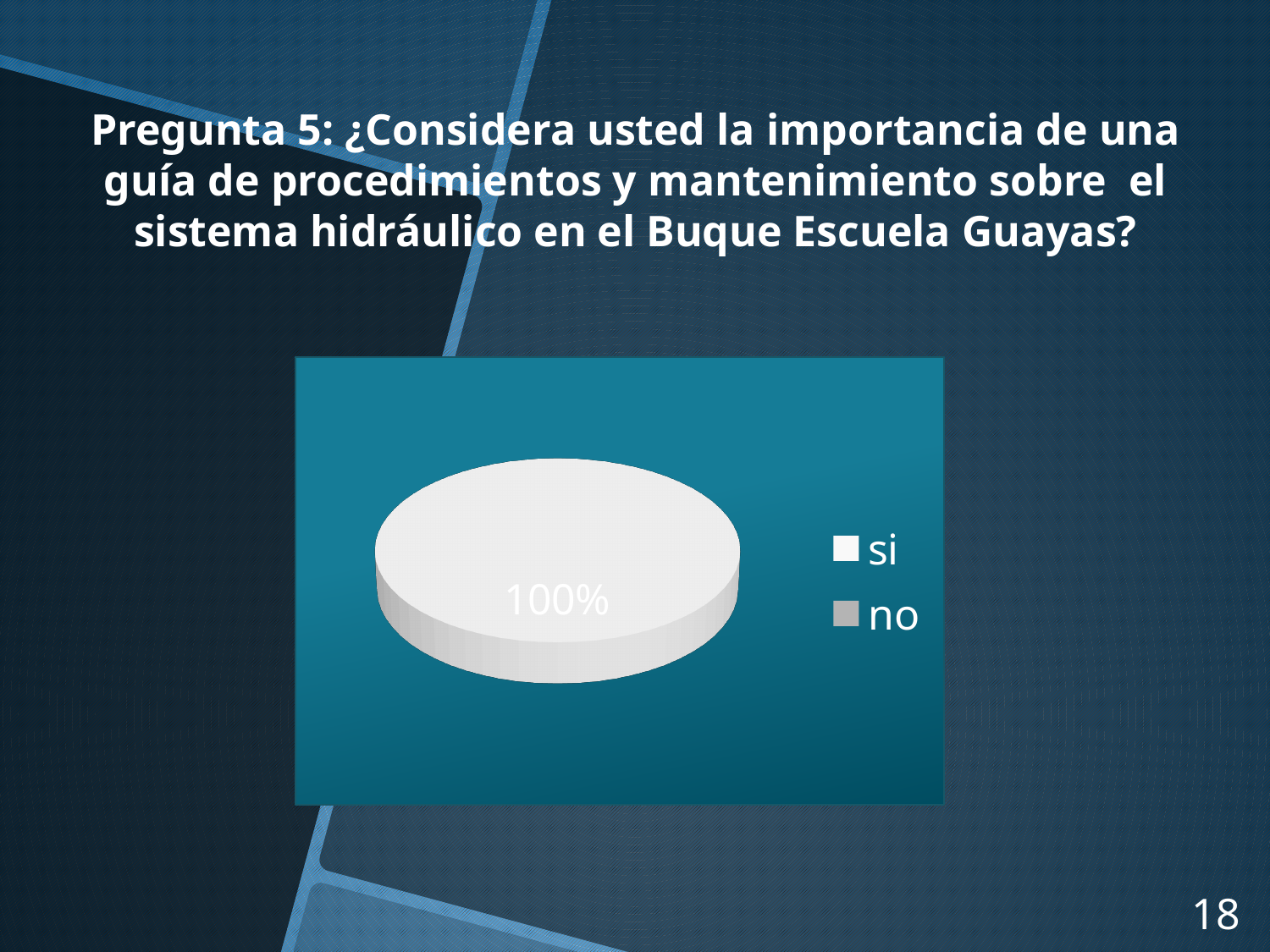
Which of the two categories, "si" or "no", has the larger share? si Is the share for "si" greater or less than 50%? greater What are the two categories listed in the legend? si and no What percentage label is printed on the pie? 100% Which category has the largest share of the pie? si What kind of chart is shown on the slide? pie chart What colour is the legend marker for "no"? gray What share of the pie does the "si" slice represent? 100% How many entries does the legend list? 2